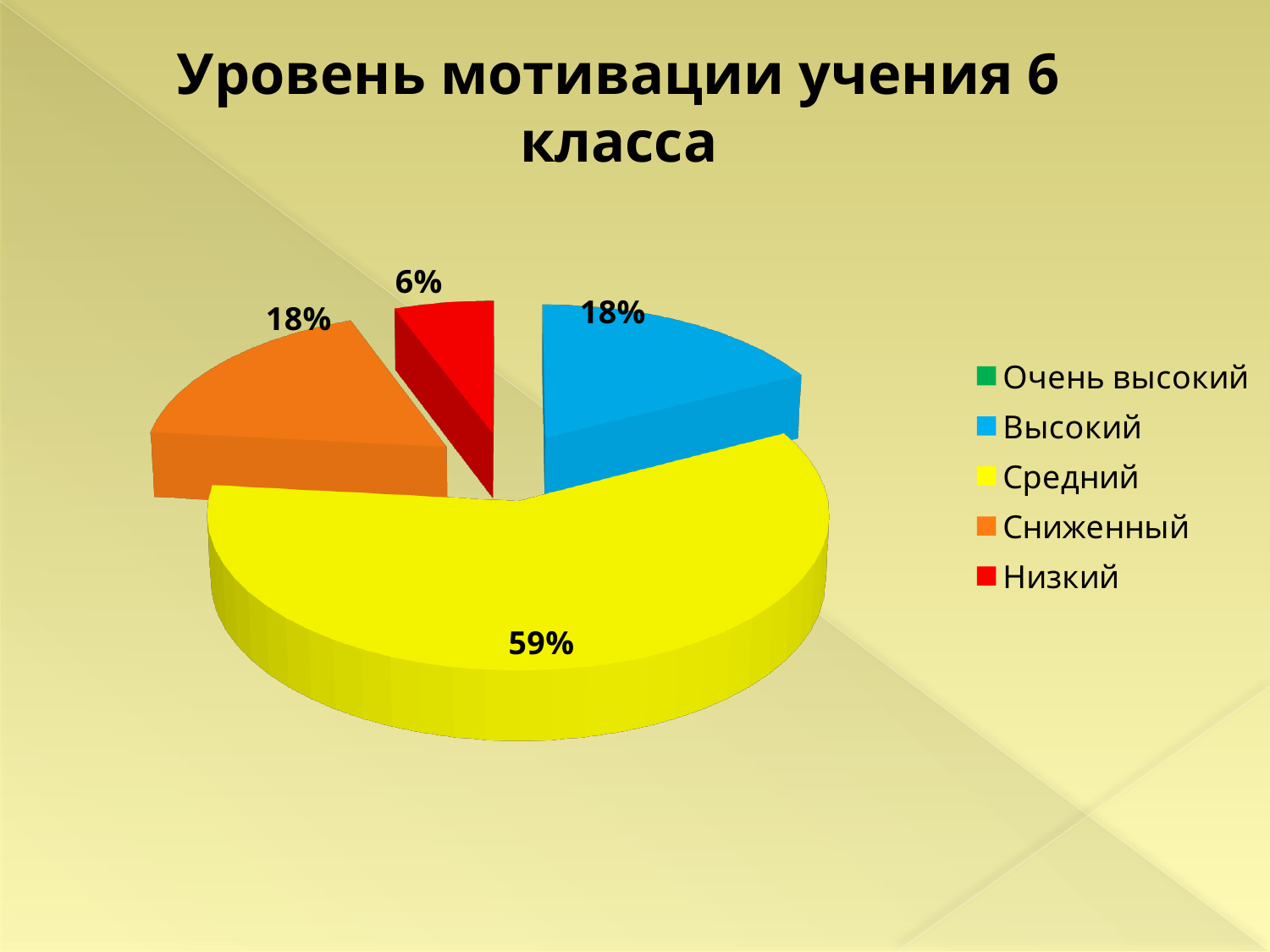
How many categories are listed in the legend? 5 What percentage is labelled for the Низкий slice? 6% Which is larger, the Низкий slice or the Высокий slice? Высокий What is the value shown for Сниженный? 18% How many percentage points larger is Средний than Высокий? 41% What percentage does the Средний slice represent? 59% What is the title of the chart? Уровень мотивации учения 6 класса Which is larger, the Средний slice or the Сниженный slice? Средний What is the value shown for Высокий? 18% What is the difference between the Сниженный and Низкий values? 12% What type of chart is shown on the slide? Pie chart Which category has the largest slice of the pie? Средний